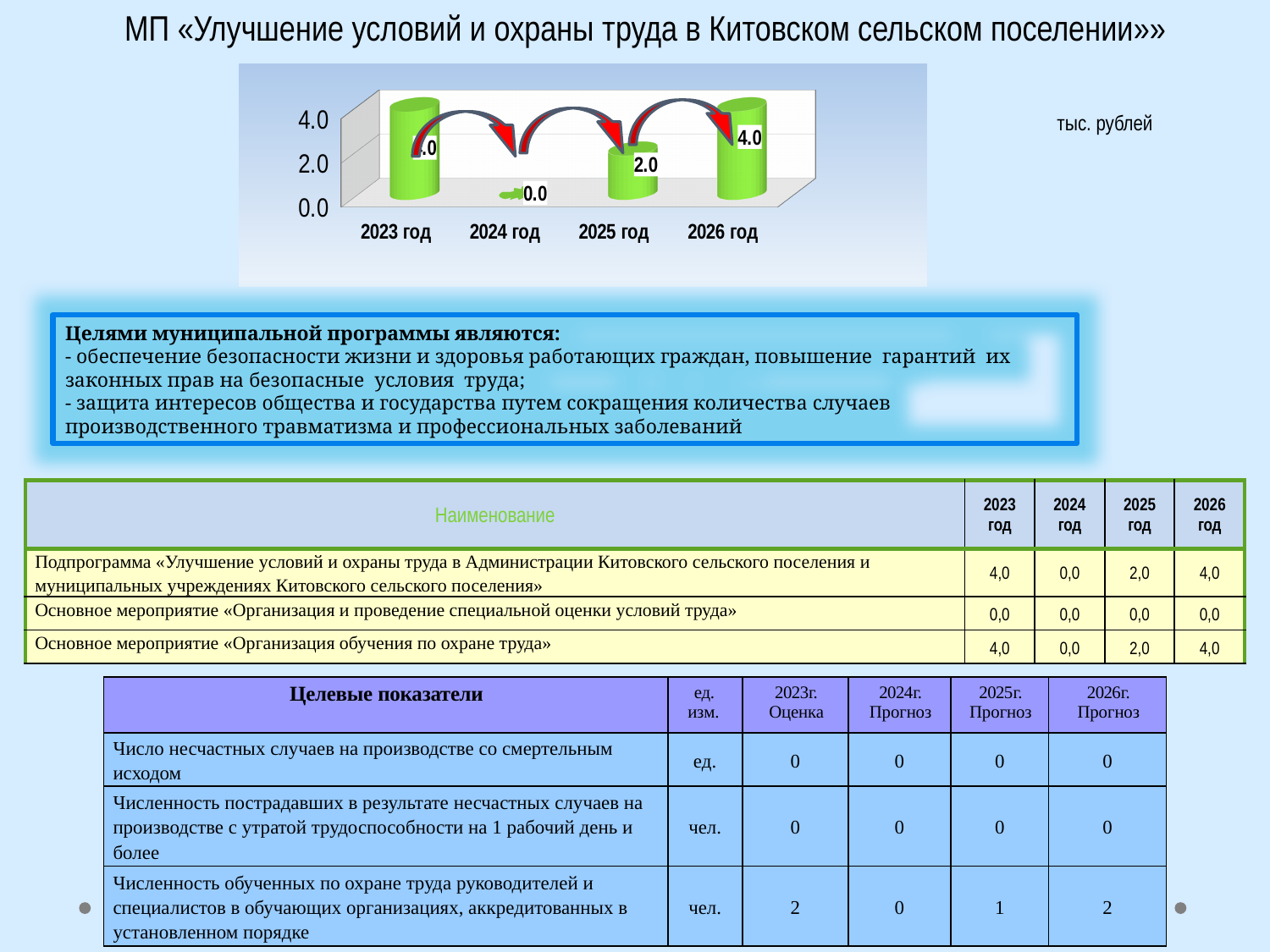
What unit of measurement is indicated next to the chart? тыс. рублей Which year has the lowest value in the chart? 2024 год What type of chart is shown at the top of the slide? bar chart What is the value for 2026 год in the chart? 4.0 What is the difference between the values for 2026 год and 2025 год in the chart? 2.0 Does the value rise or fall from 2024 год to 2026 год in the chart? rise What is the value for 2024 год in the chart? 0.0 Is the value for 2023 год in the chart greater or less than 2.0? greater What is the value for 2025 год in the chart? 2.0 How many categories (years) are shown on the x axis of the chart? 4 What colour are the bars in the chart? green Which is larger in the chart, the value for 2025 год or the value for 2026 год? 2026 год